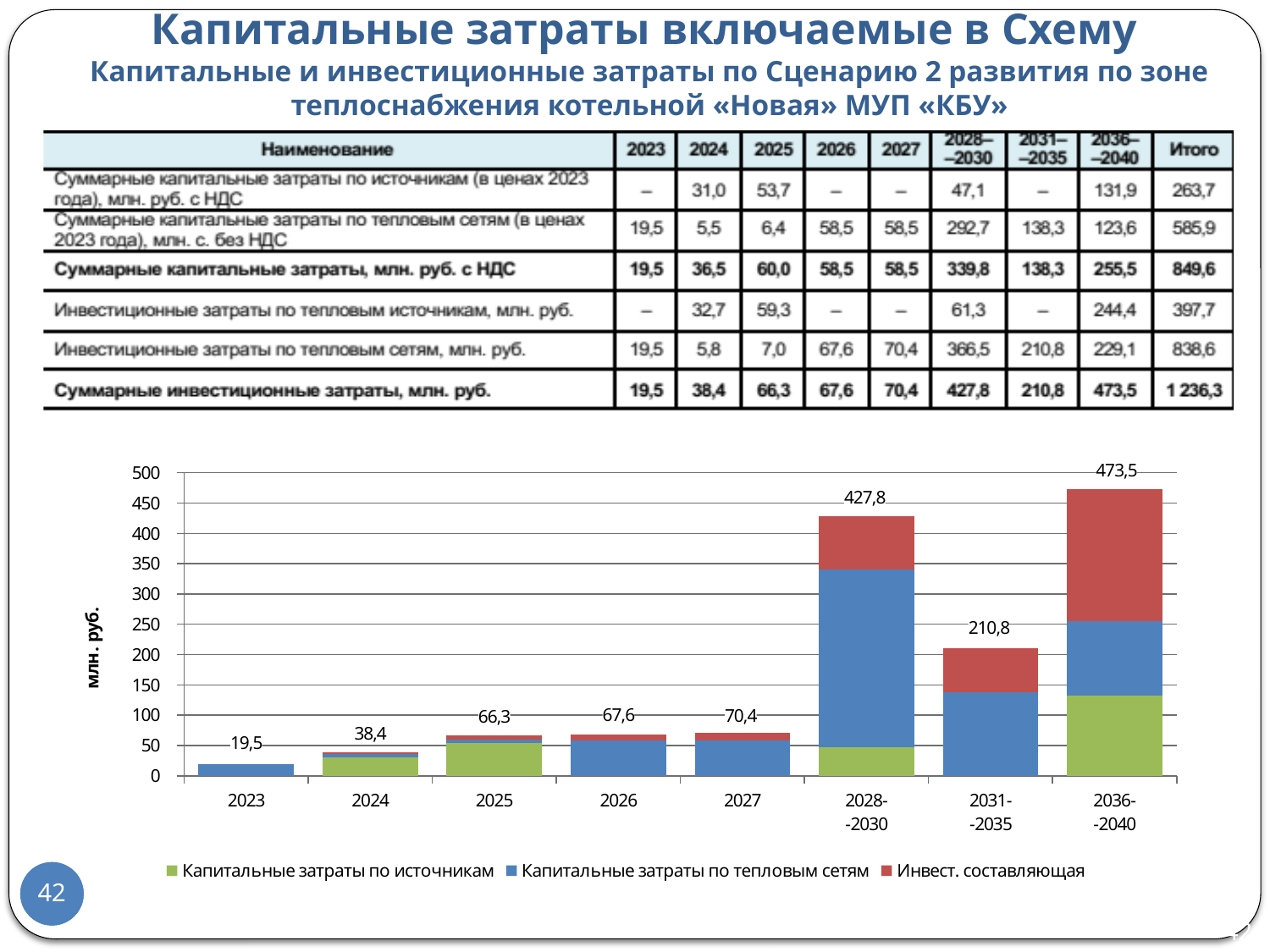
How many series does the chart legend list? 3 Which category has the lowest total in the chart? 2023 Is the total for 2031-2035 greater or less than 200? greater What is the total value of the stacked bar for 2036-2040? 473,5 Which category has the highest total in the chart? 2036-2040 Which total is larger, 2031-2035 or 2027? 2031-2035 What is the difference between the totals for 2036-2040 and 2028-2030? 45,7 What is the total value of the stacked bar for 2028-2030? 427,8 What type of chart is shown on the slide? stacked bar chart What is the total value of the stacked bar for 2023? 19,5 What is the label of the y axis of the chart? млн. руб. How many categories are shown on the x axis of the chart? 8